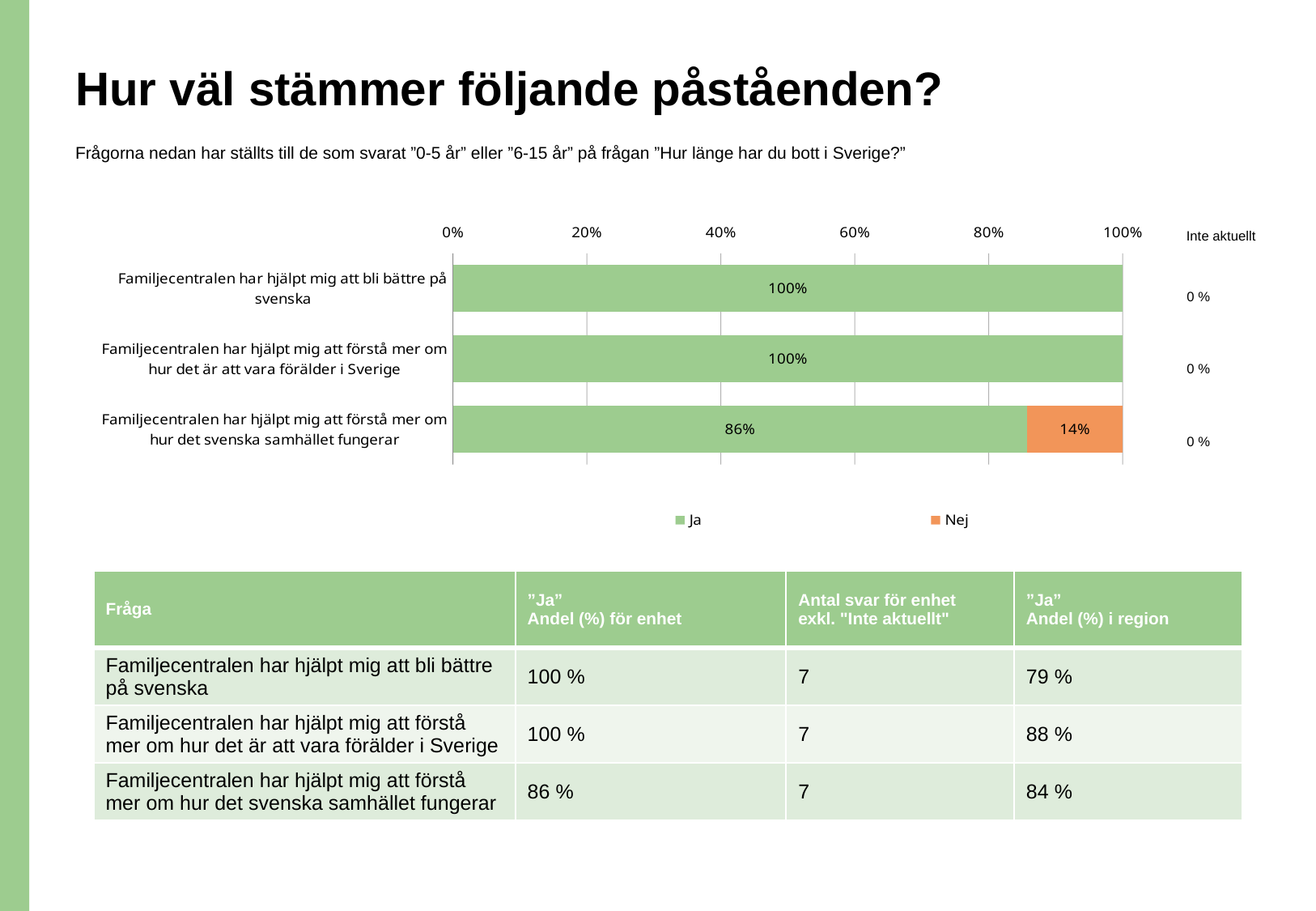
What is the difference between the "Ja" and "Nej" shares for "Familjecentralen har hjälpt mig att förstå mer om hur det svenska samhället fungerar"? 72% How many series does the chart legend list? 2 What is the "Ja" share for "Familjecentralen har hjälpt mig att förstå mer om hur det är att vara förälder i Sverige"? 100% How many statements (categories) are plotted in the chart? 3 What is the total of the stacked bar for "Familjecentralen har hjälpt mig att förstå mer om hur det svenska samhället fungerar"? 100% Which statement has the lowest "Ja" share? Familjecentralen har hjälpt mig att förstå mer om hur det svenska samhället fungerar What is the "Ja" share for "Familjecentralen har hjälpt mig att bli bättre på svenska"? 100% Which series is shown in orange in the chart? Nej Which is larger for "Familjecentralen har hjälpt mig att förstå mer om hur det svenska samhället fungerar": the "Ja" share or the "Nej" share? Ja What is the "Ja" share for "Familjecentralen har hjälpt mig att förstå mer om hur det svenska samhället fungerar"? 86% What is the "Nej" share for "Familjecentralen har hjälpt mig att förstå mer om hur det svenska samhället fungerar"? 14% What kind of chart is shown on the slide? bar chart